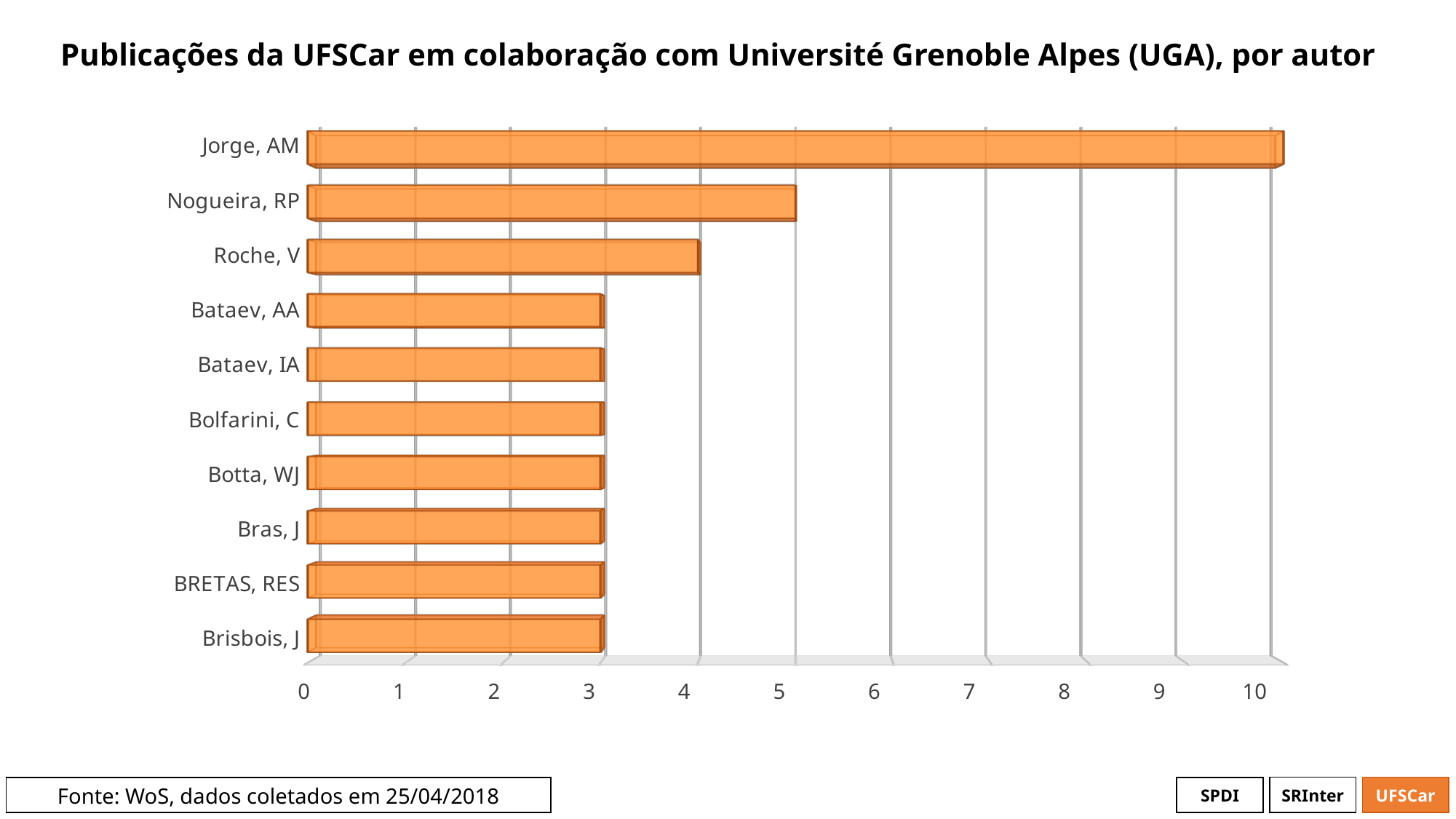
Is the value for Jorge, AM greater or less than 8? greater What is the title of the chart? Publicações da UFSCar em colaboração com Université Grenoble Alpes (UGA), por autor How many authors are shown in the chart? 10 What is the difference between the values for Jorge, AM and Nogueira, RP? 5 What is the value for Bataev, AA? 3 How many authors have a value of 3? 7 What is the value for Jorge, AM? 10 What kind of chart is shown on the slide? bar chart Which is larger, the value for Nogueira, RP or the value for Roche, V? Nogueira, RP Which author has the highest number of publications? Jorge, AM What is the value for Roche, V? 4 What is the value for Nogueira, RP? 5